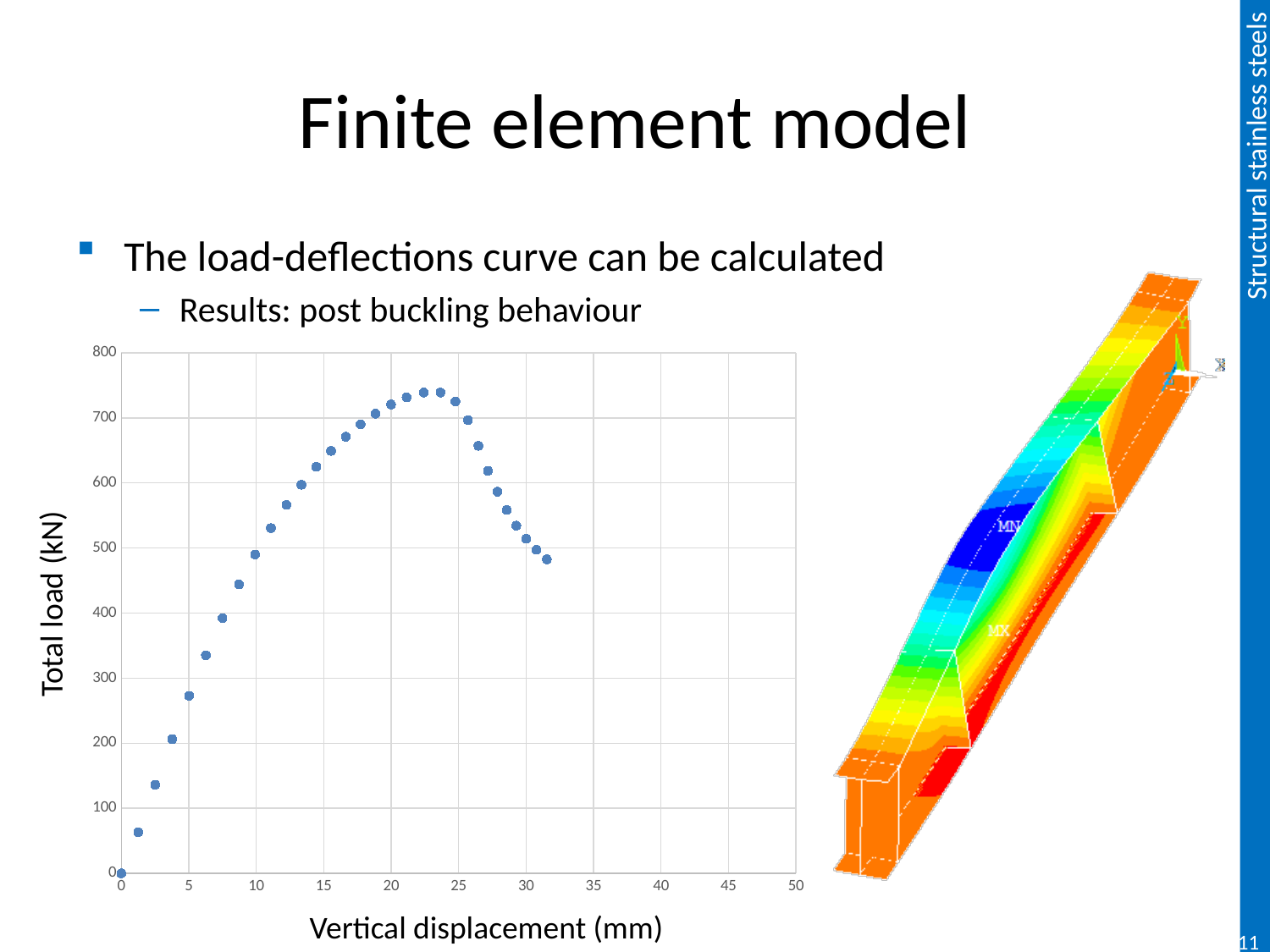
What kind of chart is shown on the slide? scatter chart What is the label of the vertical axis of the chart? Total load (kN) Does the total load rise or fall as vertical displacement increases from 0 to 20 mm? rise What is the maximum value shown on the horizontal axis of the chart? 50 Is the highest total load plotted greater or less than 700 kN? greater Is the total load at a vertical displacement of 20 mm greater or less than 700 kN? greater Does the total load rise or fall as vertical displacement increases from 25 to 30 mm? fall Is the total load at a vertical displacement of 15 mm greater or less than 600 kN? greater What is the label of the horizontal axis of the chart? Vertical displacement (mm) Is the total load at 10 mm displacement larger or smaller than the total load at 20 mm displacement? smaller